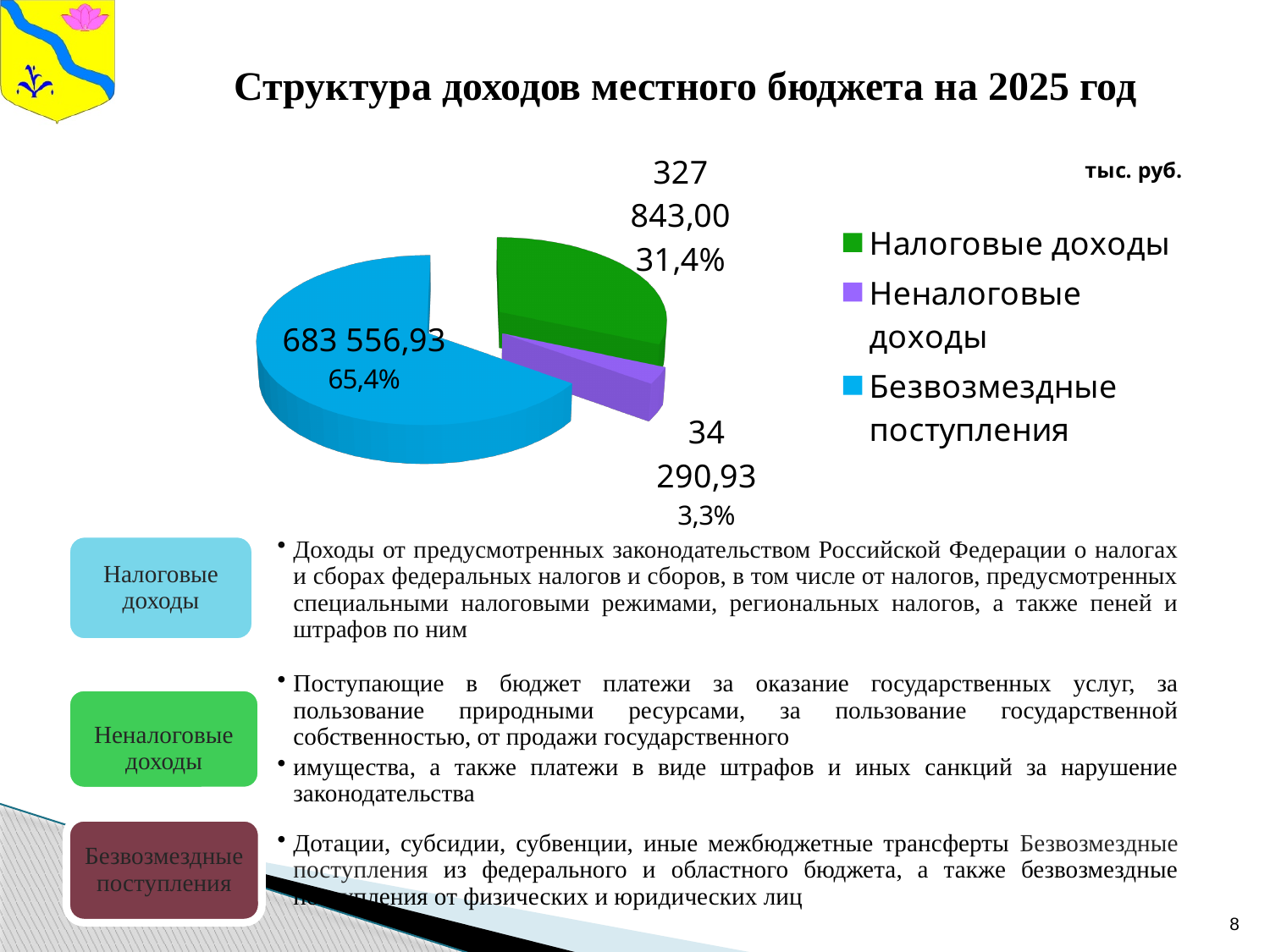
What is the difference between Безвозмездные поступления and Налоговые доходы? 355 713,93 What is the value for Неналоговые доходы? 34 290,93 Which category has the smallest slice of the pie? Неналоговые доходы Which category has the largest slice of the pie? Безвозмездные поступления What type of chart is shown on the slide? Pie chart What share of the pie does Неналоговые доходы represent? 3,3% What is the value for Налоговые доходы? 327 843,00 What is the value for Безвозмездные поступления? 683 556,93 How many categories does the pie chart have? 3 Which is larger, Налоговые доходы or Неналоговые доходы? Налоговые доходы What is the title of the chart on the slide? Структура доходов местного бюджета на 2025 год What share of the pie does Безвозмездные поступления represent? 65,4%